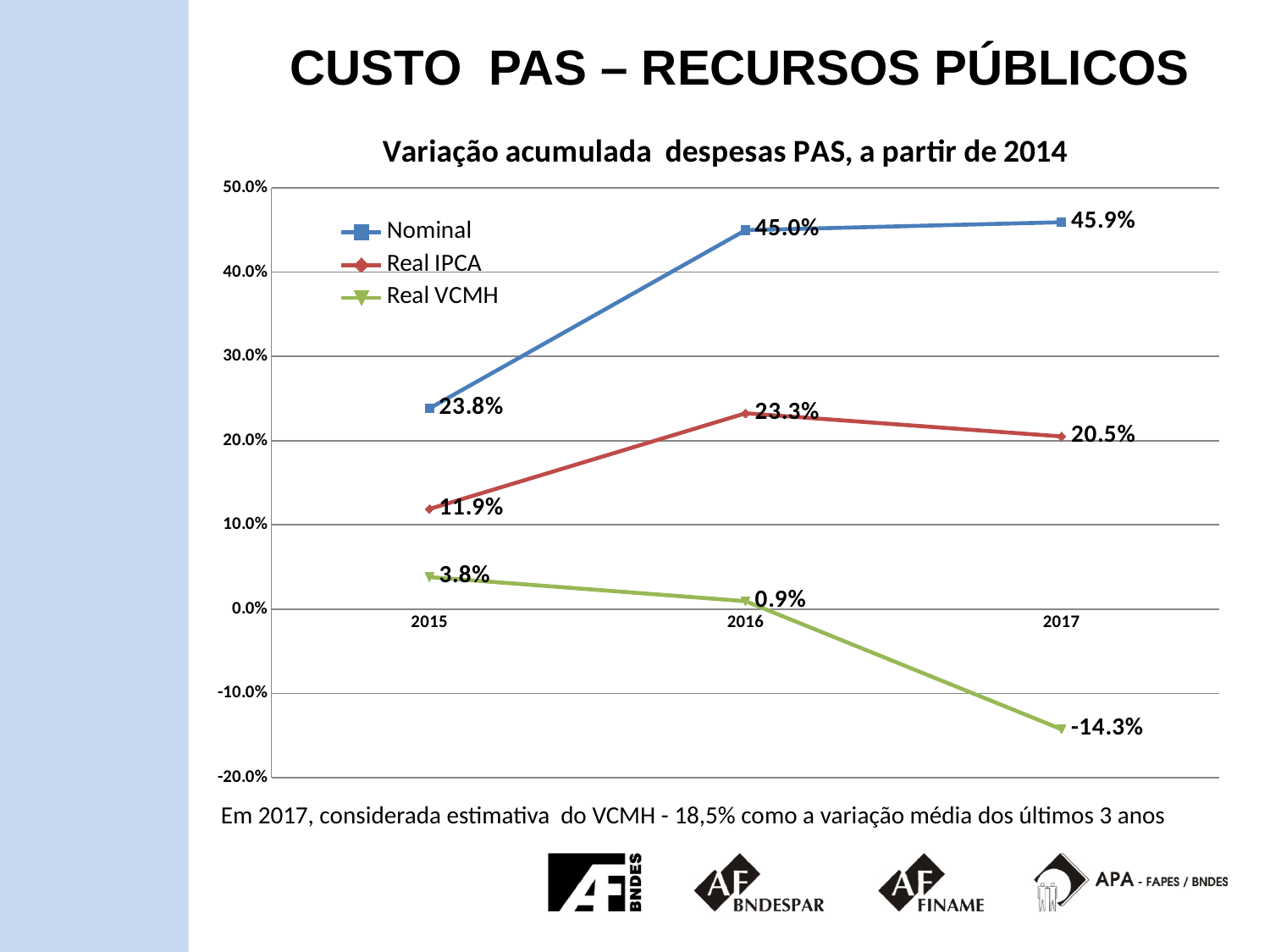
In which year is the Real VCMH series lowest? 2017 What is the Nominal value for 2017? 45.9% What is the Real VCMH value for 2016? 0.9% What is the Real IPCA value for 2015? 11.9% Does the Real VCMH series rise or fall from 2015 to 2017? Fall What kind of chart is shown? Line chart What is the title of the chart? Variação acumulada despesas PAS, a partir de 2014 In which year is the Real IPCA series highest? 2016 How many series does the legend list? 3 Which is larger in 2015, the Nominal value or the Real IPCA value? Nominal What is the difference between the Nominal value and the Real IPCA value in 2016? 21.7% What is the Real VCMH value for 2017? -14.3%